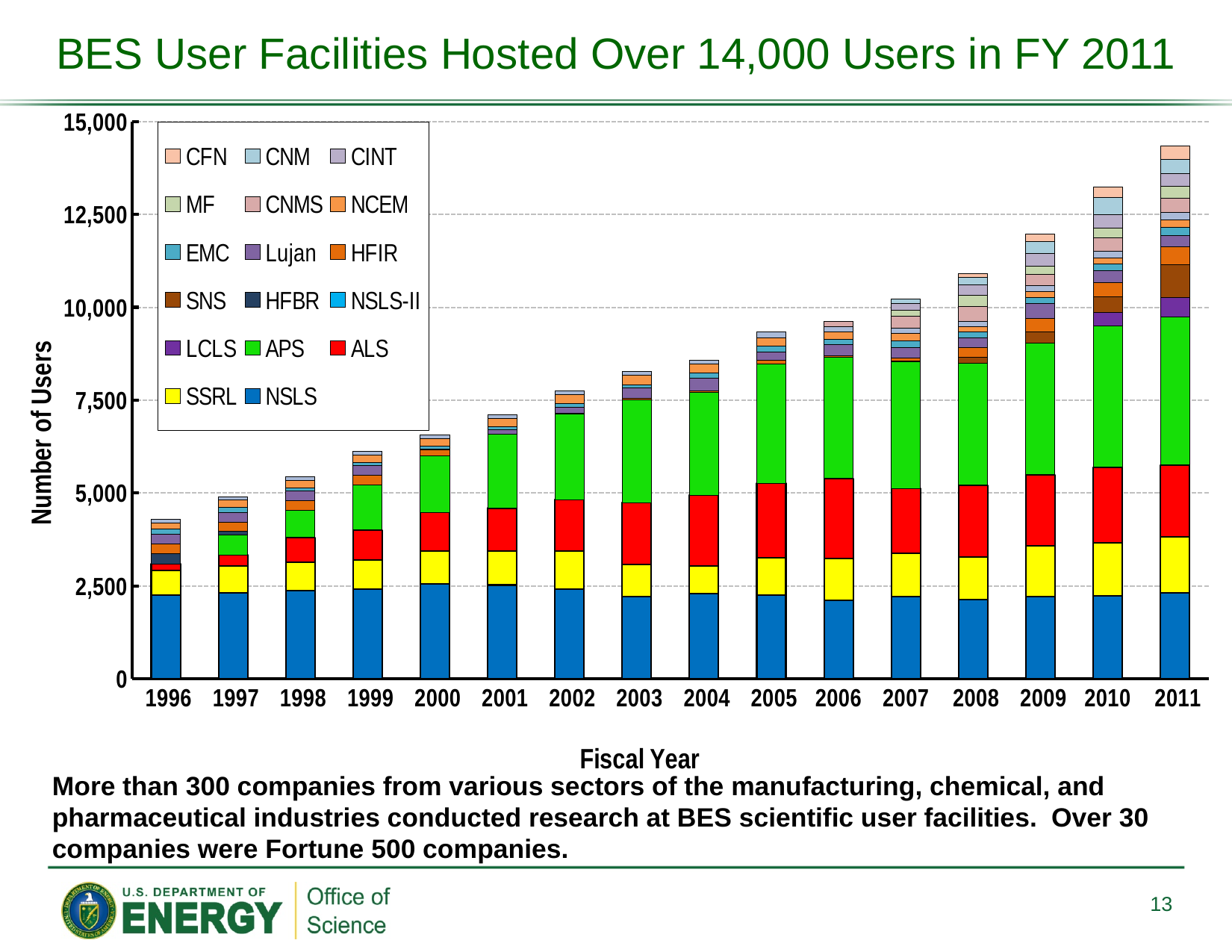
How many fiscal years are shown on the x axis of the chart? 16 Which fiscal year has more total users, 2010 or 2011? 2011 Which fiscal year has the tallest stacked bar (the most users)? 2011 What is the label of the chart's vertical axis? Number of Users What kind of chart is shown on the slide? Stacked bar chart Is the total number of users in 2011 greater or less than 12,500? greater Is the total number of users in 1996 greater or less than 5,000? less Which fiscal year has the shortest stacked bar (the fewest users)? 1996 Is the total number of users in 2003 greater or less than 10,000? less How many series does the chart's legend list? 17 Do the total number of users generally rise or fall from 1996 to 2011? Rise